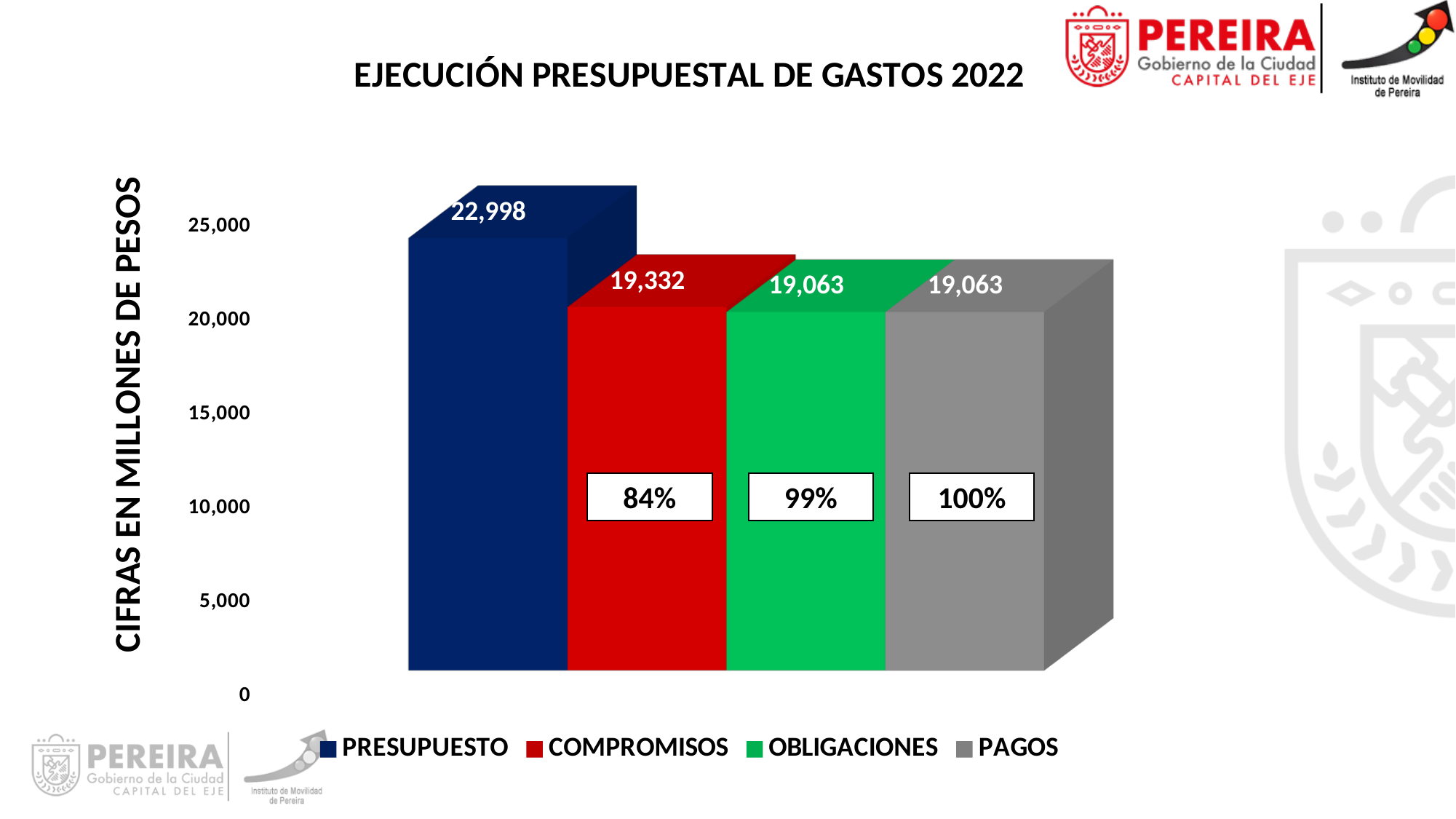
Is the value for PAGOS greater or less than 20,000? less How many series does the legend list? 4 What is the difference between PRESUPUESTO and COMPROMISOS? 3,666 What percentage label is shown on the COMPROMISOS bar? 84% Which is larger, PRESUPUESTO or COMPROMISOS? PRESUPUESTO What kind of chart is shown on the slide? bar chart What is the value for PRESUPUESTO? 22,998 Which series has the highest value? PRESUPUESTO What is the difference between COMPROMISOS and OBLIGACIONES? 269 What is the value for COMPROMISOS? 19,332 What is the value for PAGOS? 19,063 What is the value for OBLIGACIONES? 19,063